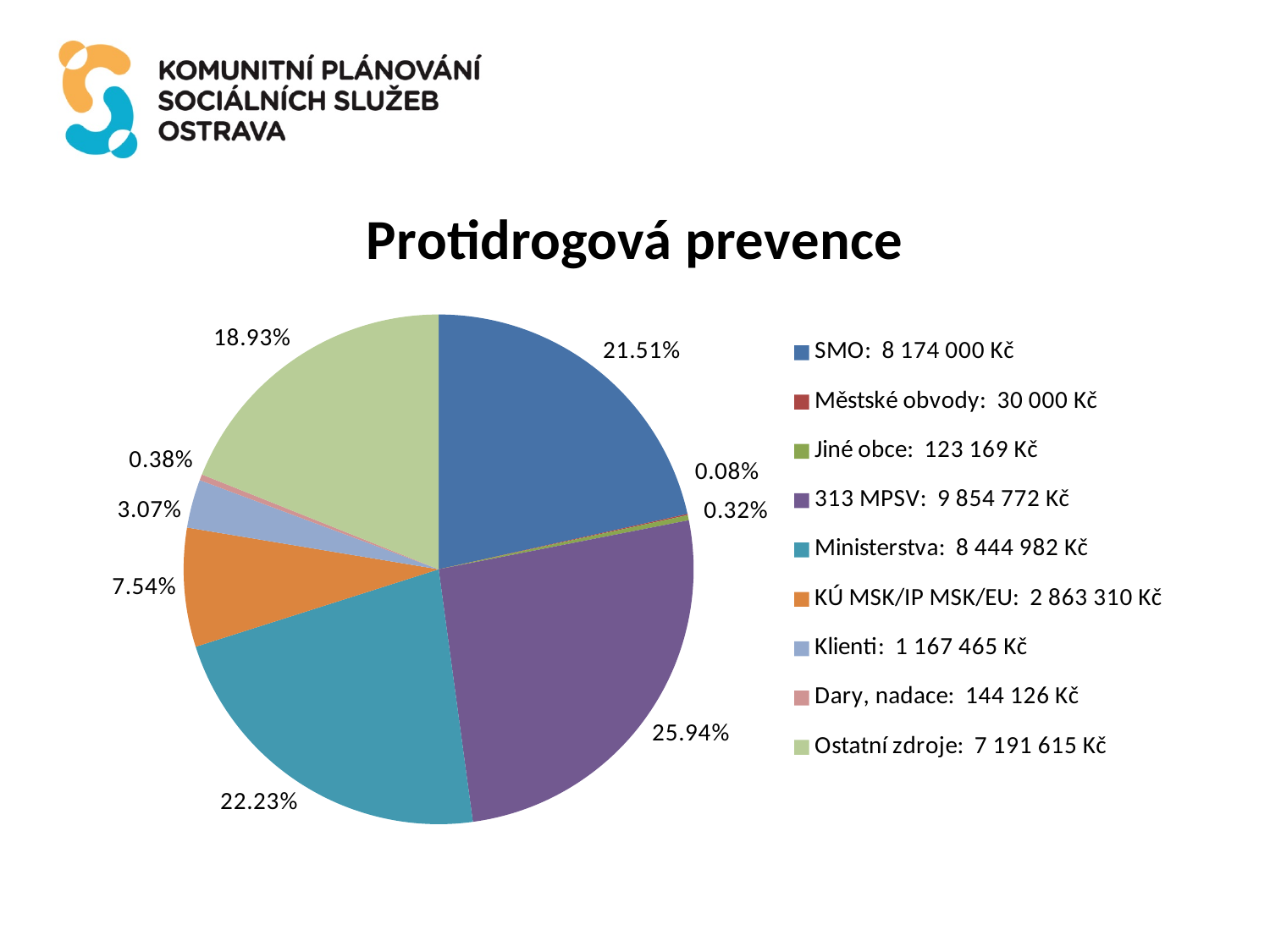
How many slices does the pie chart have? 9 Which has a larger share: Ministerstva or Ostatní zdroje? Ministerstva What share of the pie does SMO represent? 21.51% What amount in Kč is listed in the legend for Ministerstva? 8 444 982 Kč What type of chart is shown on the slide? pie chart What share of the pie does 313 MPSV represent? 25.94% What amount in Kč is listed in the legend for Klienti? 1 167 465 Kč What share of the pie does Ostatní zdroje represent? 18.93% What is the title of the chart? Protidrogová prevence What is the difference in percentage points between the shares of 313 MPSV and SMO? 4.43 Which category has the smallest share of the pie? Městské obvody Which category has the largest share of the pie? 313 MPSV